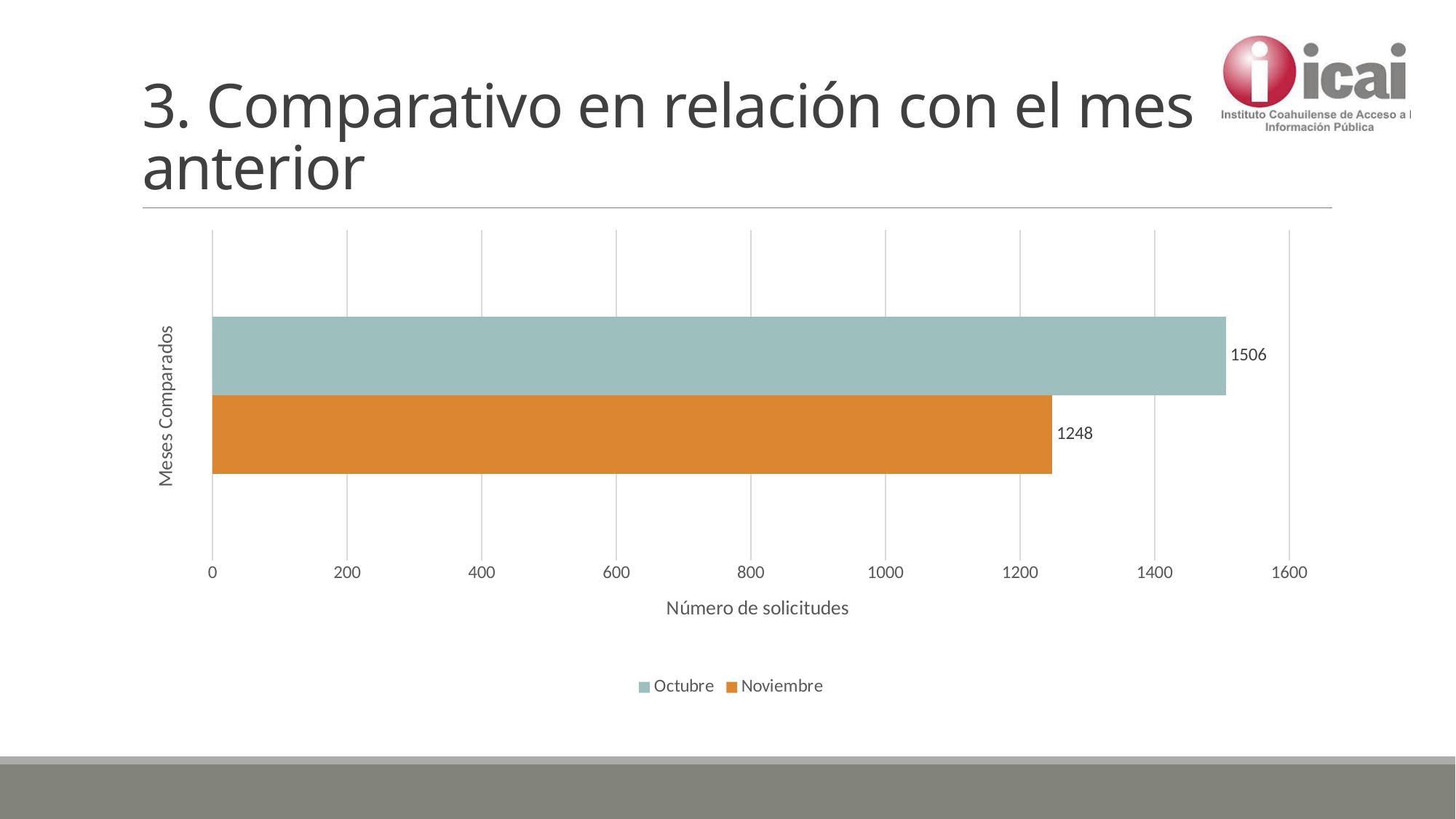
What is the value for Noviembre? 1248 What is the value for Octubre? 1506 Which series has the lowest value? Noviembre Is the value for Noviembre greater or less than 1400? less What kind of chart is shown on the slide? bar chart Which series has the highest value? Octubre What is the label of the vertical axis? Meses Comparados How many series does the legend list? 2 What is the label of the horizontal axis? Número de solicitudes Is the value for Octubre greater or less than 1400? greater Which is larger, the value for Octubre or the value for Noviembre? Octubre What is the difference between the values for Octubre and Noviembre? 258